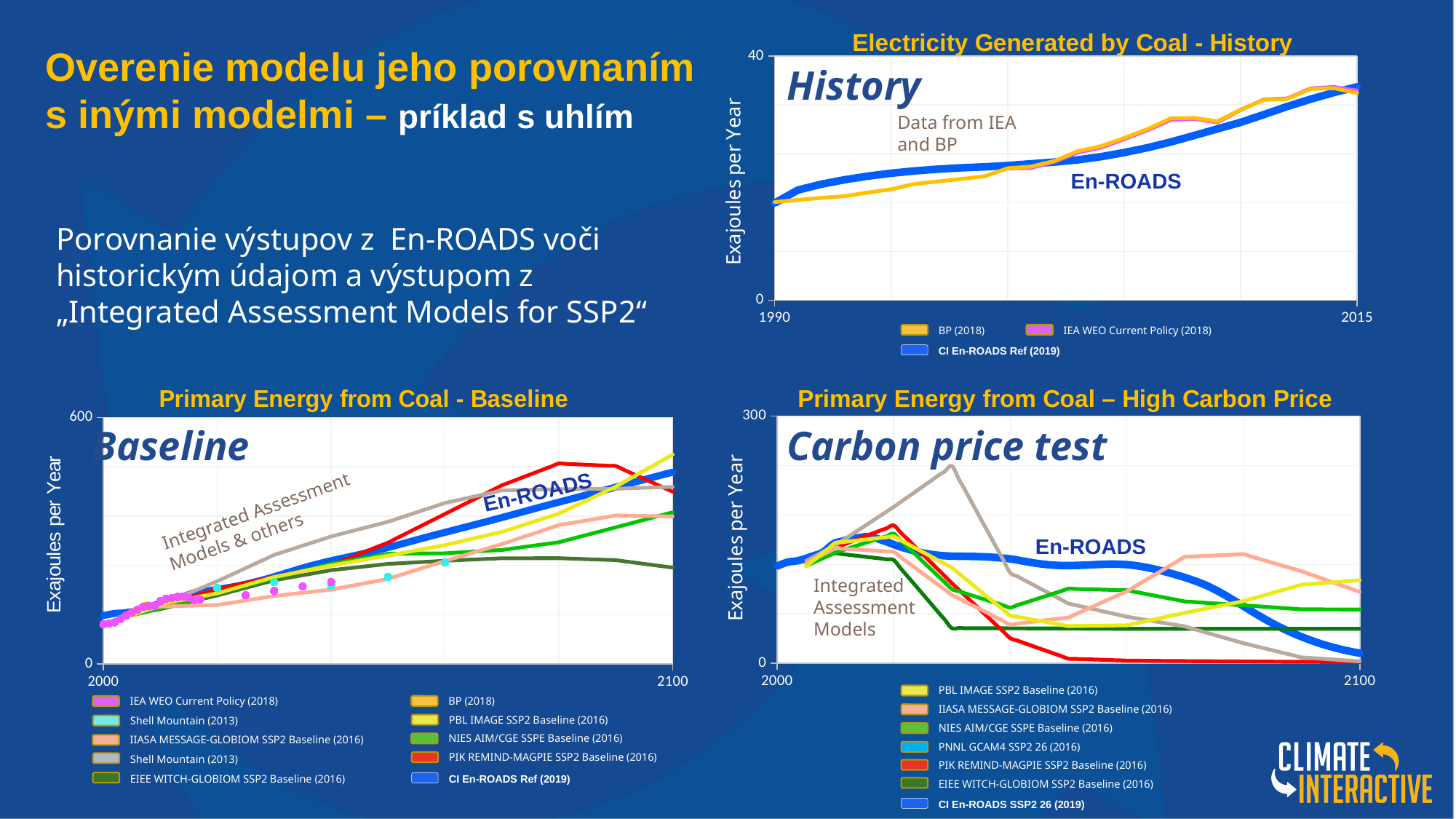
In the 'Primary Energy from Coal – High Carbon Price' chart, which is larger in 2100: PBL IMAGE SSP2 Baseline (2016) or CI En-ROADS SSP2 26 (2019)? PBL IMAGE SSP2 Baseline (2016) In the 'Primary Energy from Coal - Baseline' chart, which series is lowest in 2100? EIEE WITCH-GLOBIOM SSP2 Baseline (2016) What kind of chart is the 'Electricity Generated by Coal - History' chart? line chart How many series does the legend of the 'Primary Energy from Coal – High Carbon Price' chart list? 7 How many series does the legend of the 'Primary Energy from Coal - Baseline' chart list? 10 In the 'Electricity Generated by Coal - History' chart, do the values rise or fall from 1990 to 2015? rise How many series does the legend of the 'Electricity Generated by Coal - History' chart list? 3 What is the last year shown on the x axis of the 'Electricity Generated by Coal - History' chart? 2015 What is the y-axis label of the 'Electricity Generated by Coal - History' chart? Exajoules per Year In the 'Primary Energy from Coal - Baseline' chart, is the CI En-ROADS Ref (2019) value in 2100 greater or less than 600? less In the 'Primary Energy from Coal - Baseline' chart, does the CI En-ROADS Ref (2019) line rise or fall from 2000 to 2100? rise